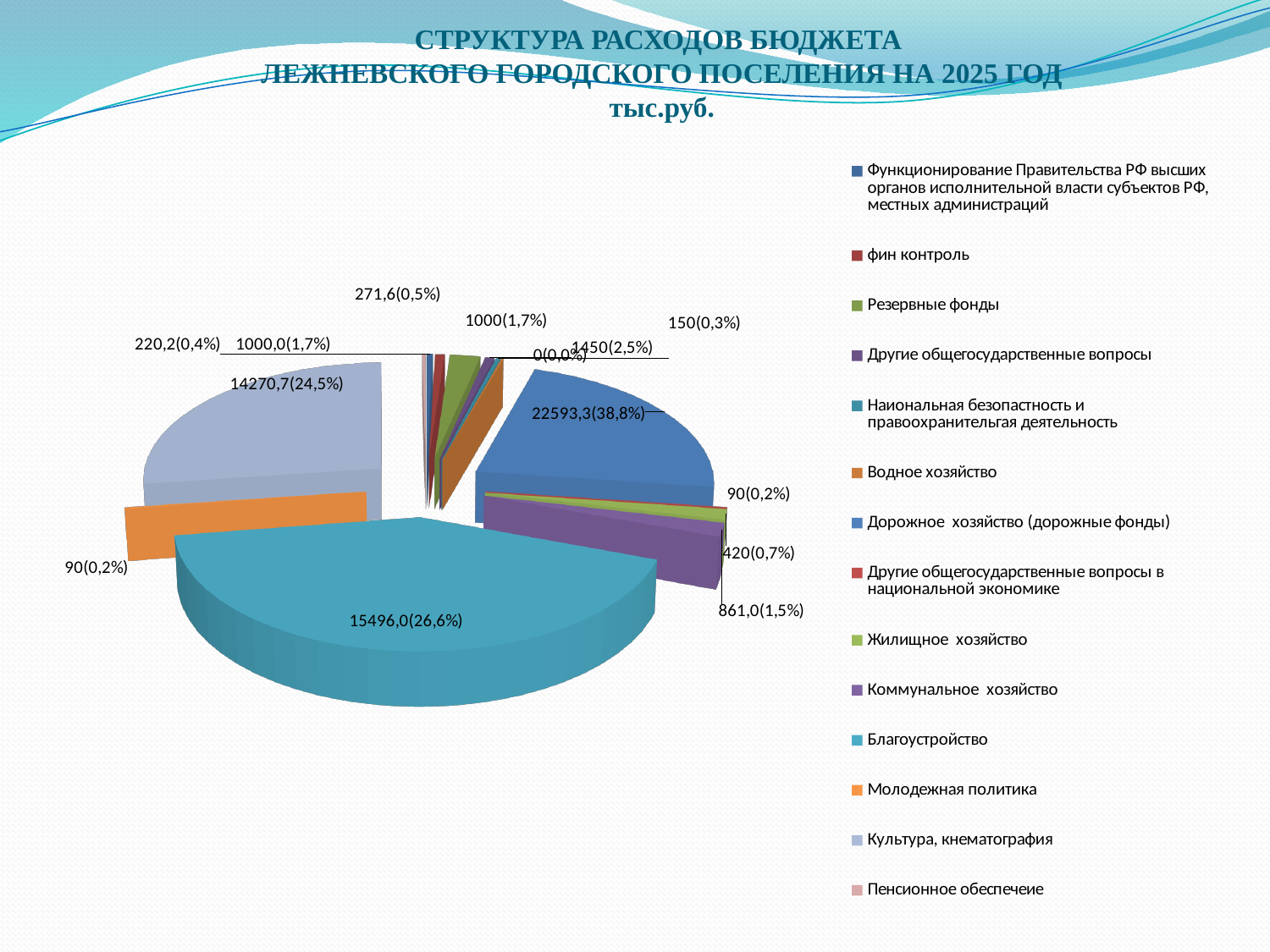
What is the smallest value printed on a data label of the pie chart? 0(0,0%) What kind of chart is shown on the slide? pie chart Which is larger, the slice for Благоустройство or the slice for Культура, кнематография? Благоустройство Which category has the largest slice of the pie chart? Дорожное хозяйство (дорожные фонды) How many categories does the legend of the pie chart list? 14 What value is shown for Дорожное хозяйство (дорожные фонды)? 22593,3 What is the difference between the values for Дорожное хозяйство (дорожные фонды) and Благоустройство? 7097,3 What share of the pie does Благоустройство have? 26,6% In what units are the values of the chart given, according to the title? тыс.руб. What is the difference between the values for Благоустройство and Культура, кнематография? 1225,3 What value is shown for Культура, кнематография? 14270,7 What share of the pie does Культура, кнематография have? 24,5%